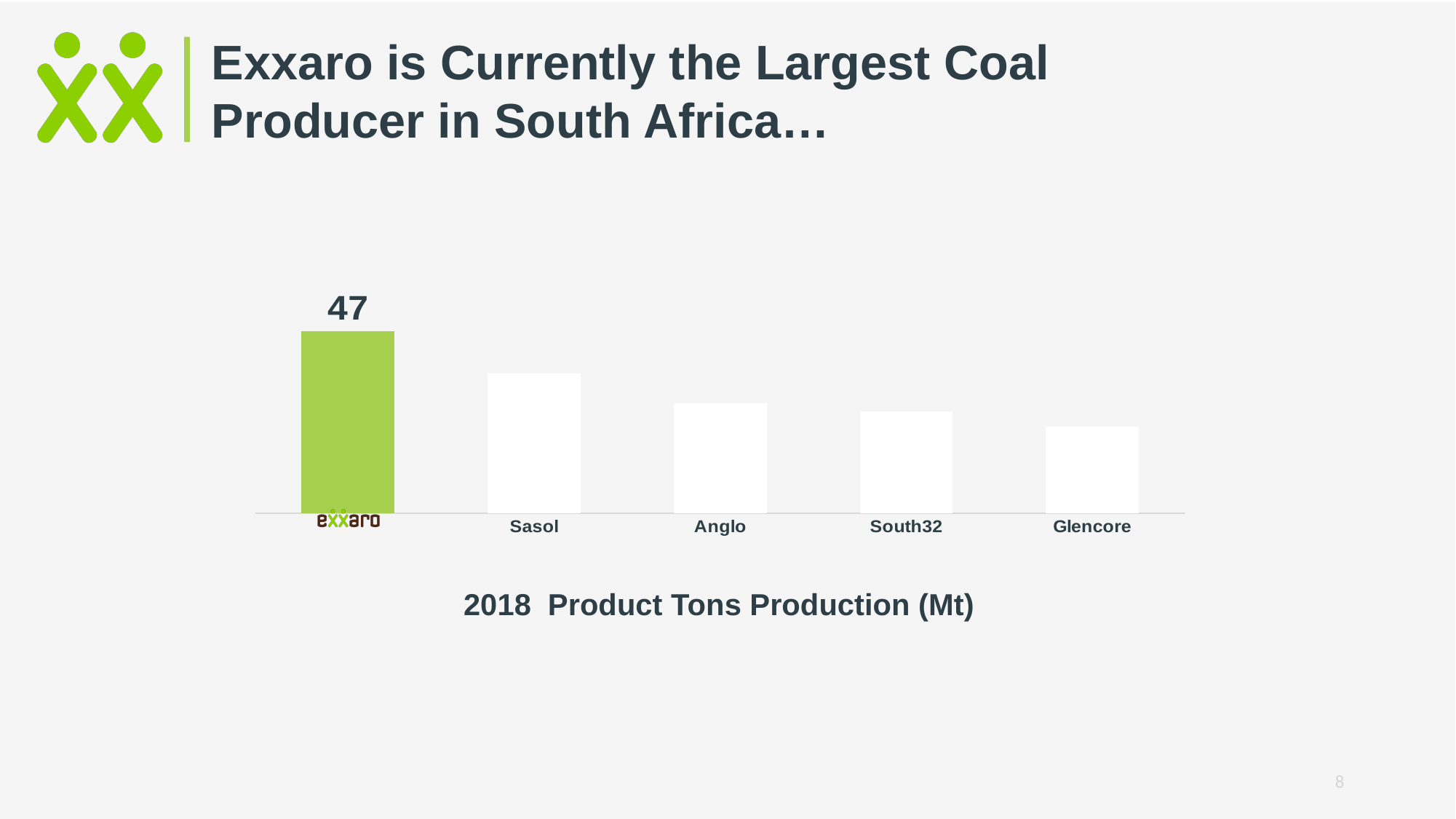
What colour is the Exxaro bar in the chart? Green What is the 2018 product tons production value shown for Exxaro? 47 Which company is listed second from the left on the x axis? Sasol Which company has the lowest bar in the chart? Glencore Which has the larger bar, Sasol or Anglo? Sasol What kind of chart is shown on the slide? Bar chart Do the bar values rise or fall from left to right across the chart? Fall What is the title shown beneath the chart? 2018 Product Tons Production (Mt) How many companies are shown in the chart? 5 Which has the larger bar, Sasol or Glencore? Sasol Which company has the highest bar in the chart? Exxaro Which has the larger bar, Exxaro or Glencore? Exxaro